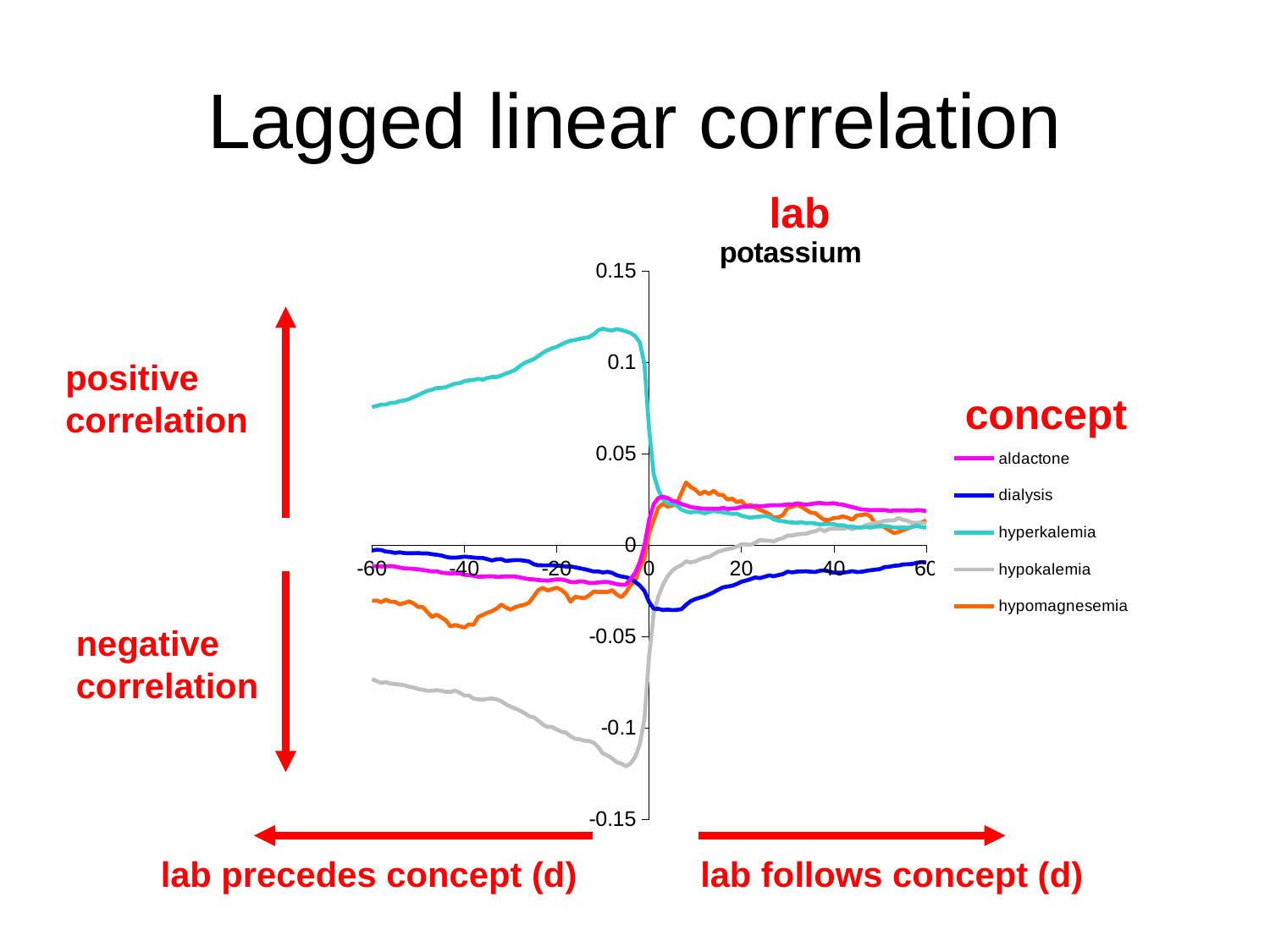
Is the peak value of the hyperkalemia line greater or less than 0.1? greater Does the hypokalemia line rise or fall between lag -60 and lag -10? fall Which series is drawn in orange in the legend? hypomagnesemia Which series has the lowest value at lag -60? hypokalemia At lag 60, which series has the higher value, aldactone or dialysis? aldactone Is the value of the hypomagnesemia line at lag -40 greater or less than 0? less What kind of chart is shown on the slide? line chart Which series has the highest value at lag -60? hyperkalemia Does the hyperkalemia line rise or fall between lag -60 and lag -10? rise What is the title printed above the chart's plot area? potassium Is the lowest value of the hypokalemia line greater or less than -0.1? less How many series does the legend list? 5